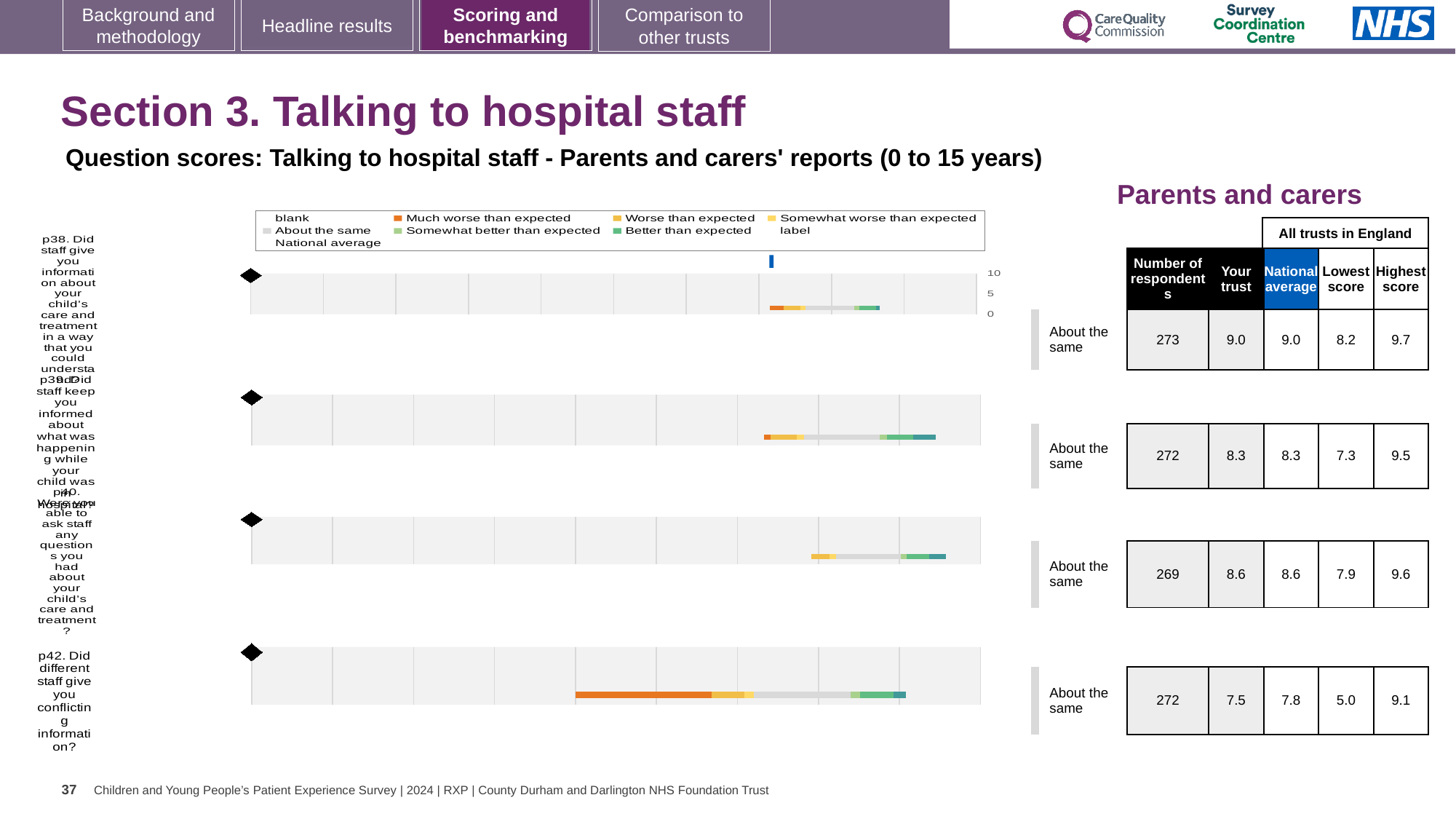
What benchmark label is given to the trust's result for each of the four questions? About the same Which has the larger 'Your trust' score: p39 or p40? p40 Which question has the lowest 'Your trust' score? p42 For p42, what is the difference between the National average (7.8) and the Your trust score (7.5)? 0.3 How many respondents are listed for p42 (Did different staff give you conflicting information?)? 272 What kind of chart is used to show the question scores on this slide? bar chart What is the Lowest score across all trusts in England for p42? 5.0 What is the 'Your trust' score for p38 (Did staff give you information about your child's care and treatment in a way that you could understand?)? 9.0 Which question has the highest 'Your trust' score? p38 In the chart legend, which category is shown in orange? Much worse than expected How many survey questions (p38, p39, p40, p42) are plotted on the slide? 4 What is the Highest score across all trusts in England for p40 (Were you able to ask staff any questions you had about your child's care and treatment?)? 9.6